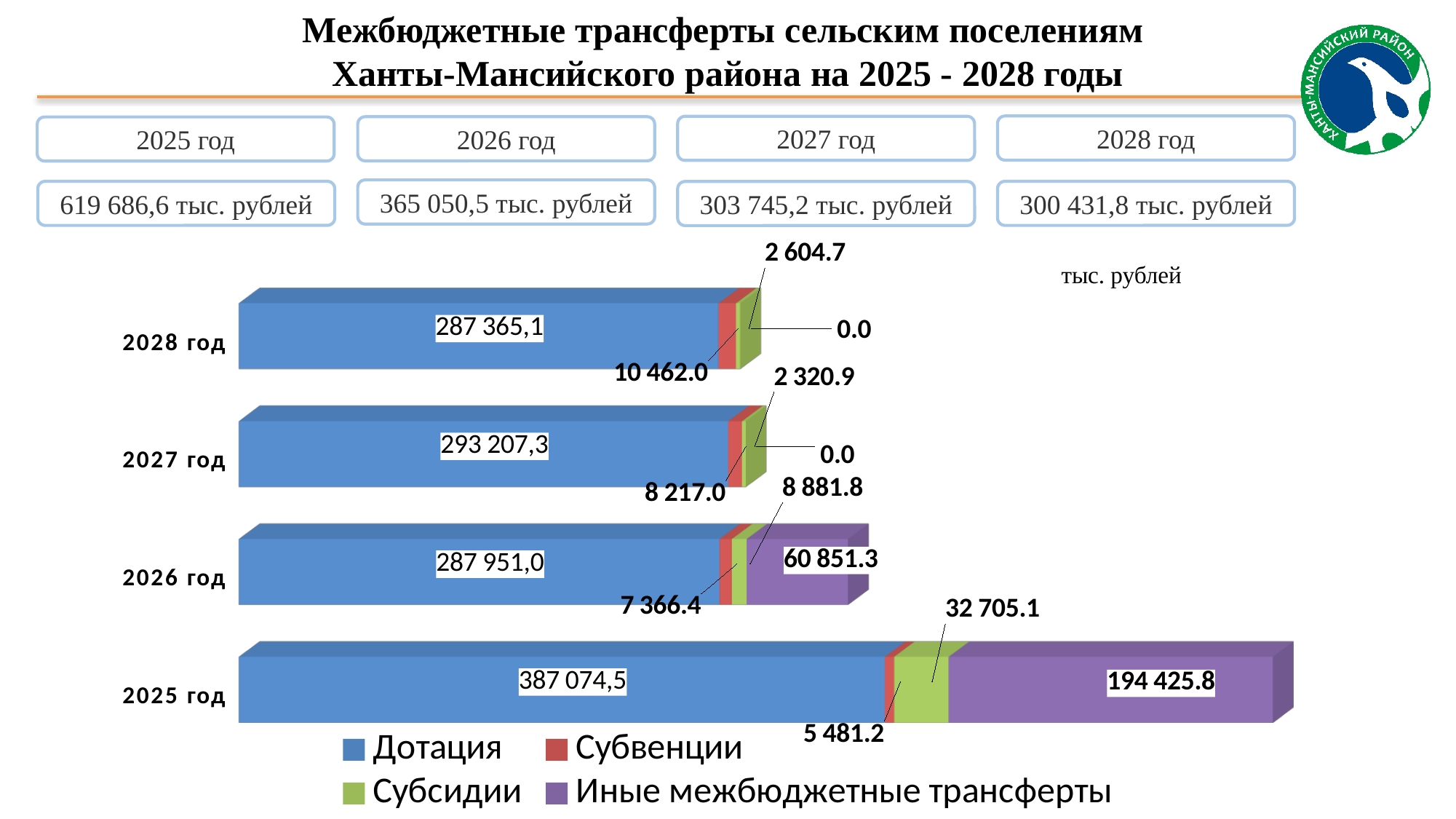
What is the total of the stacked bar for 2025 год? 619 686,6 What type of chart is shown on the slide? Bar chart What is the value of Дотация for 2025 год? 387 074,5 How many years (categories) are plotted in the chart? 4 What is the value of Субвенции for 2028 год? 10 462.0 What is the difference between Иные межбюджетные трансферты for 2025 год and for 2026 год? 133 574.5 What is the value of Субсидии for 2027 год? 2 320.9 What is the value of Иные межбюджетные трансферты for 2026 год? 60 851.3 Which year has the lowest value of Субвенции? 2025 год Which year has the highest value of Дотация? 2025 год How many series does the legend list? 4 Which is larger: Субсидии for 2026 год or Субсидии for 2028 год? 2026 год